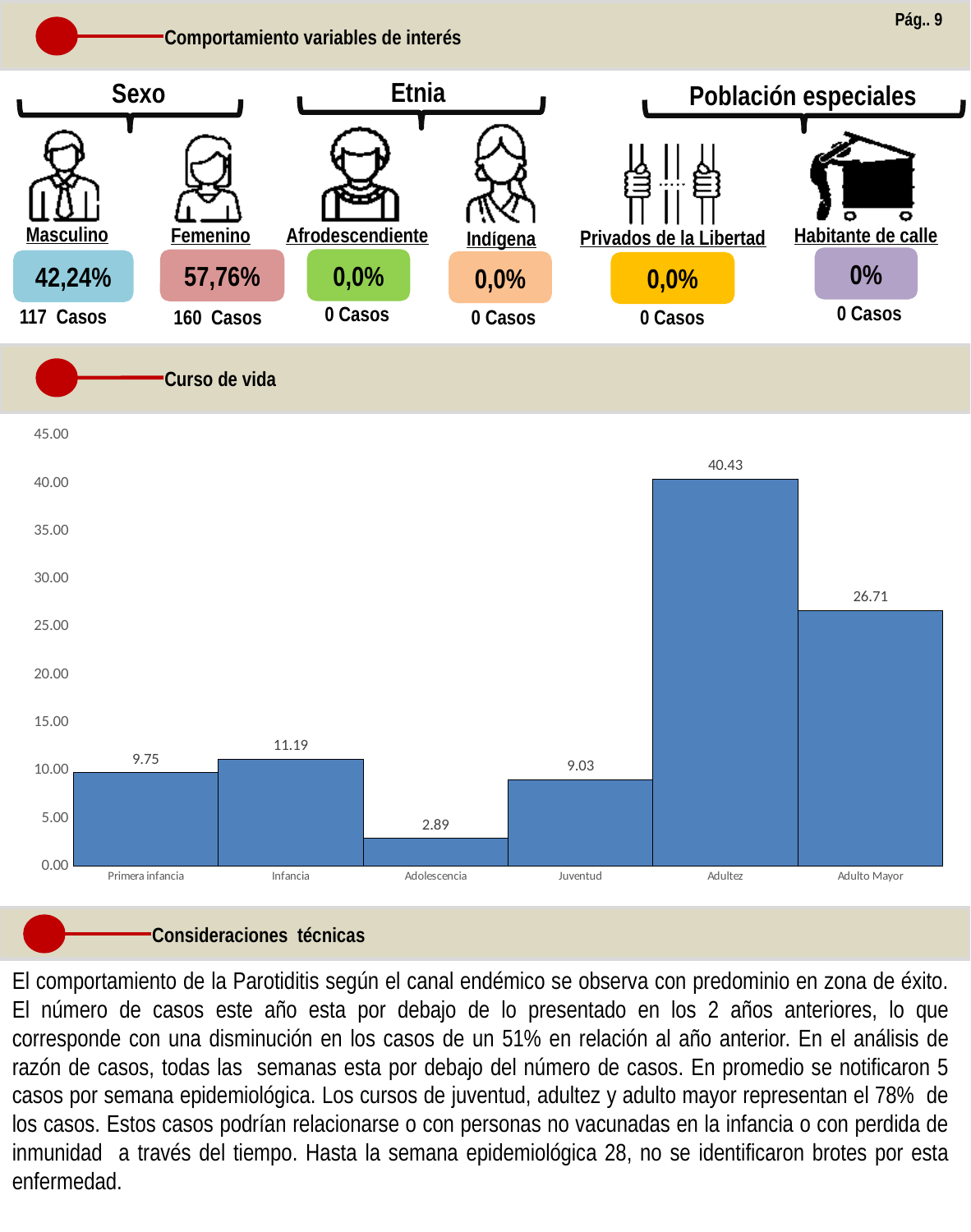
What is the value for Adultez in the Curso de vida chart? 40.43 What is the value for Adolescencia in the Curso de vida chart? 2.89 Which category has the lowest value in the Curso de vida chart? Adolescencia How many categories are shown on the x axis of the Curso de vida chart? 6 Which category has the highest value in the Curso de vida chart? Adultez Is the value for Adulto Mayor in the Curso de vida chart greater or less than 25.00? greater What is the difference between the values for Infancia and Primera infancia in the Curso de vida chart? 1.44 What is the value for Infancia in the Curso de vida chart? 11.19 In the Curso de vida chart, which is larger: the value for Primera infancia or the value for Juventud? Primera infancia What is the value for Adulto Mayor in the Curso de vida chart? 26.71 What is the difference between the values for Adultez and Adulto Mayor in the Curso de vida chart? 13.72 What kind of chart is the Curso de vida chart? bar chart